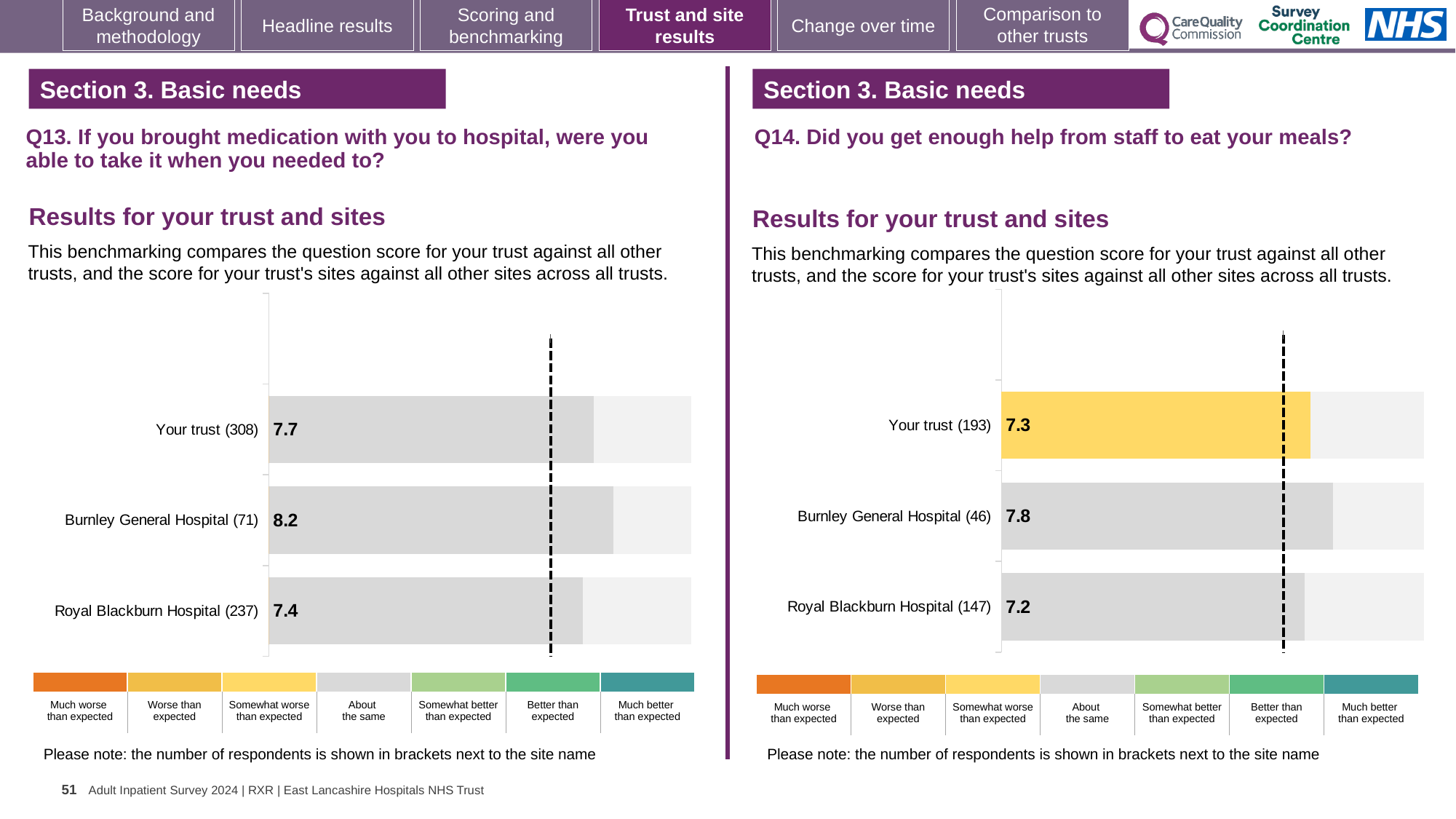
How many bars are plotted in the Q13 chart on the left? 3 In the Q14 chart on the right, what is the difference between the scores for Burnley General Hospital and Your trust? 0.5 In the Q13 chart on the left, which site or trust has the lowest score? Royal Blackburn Hospital In the Q13 chart on the left, how many respondents are shown for Royal Blackburn Hospital? 237 In the Q14 chart on the right, is the score for Burnley General Hospital larger or smaller than the score for Your trust? larger What type of chart is used for the Q14 results on the right? Bar chart In the Q13 chart on the left, what is the score for Burnley General Hospital? 8.2 In the Q14 chart on the right, what is the score for Your trust? 7.3 In the Q14 chart on the right, what is the score for Royal Blackburn Hospital? 7.2 In the Q13 chart on the left, what is the score for Your trust? 7.7 In the Q13 chart on the left, what is the difference between the scores for Burnley General Hospital and Royal Blackburn Hospital? 0.8 In the Q14 chart on the right, which site or trust has the highest score? Burnley General Hospital